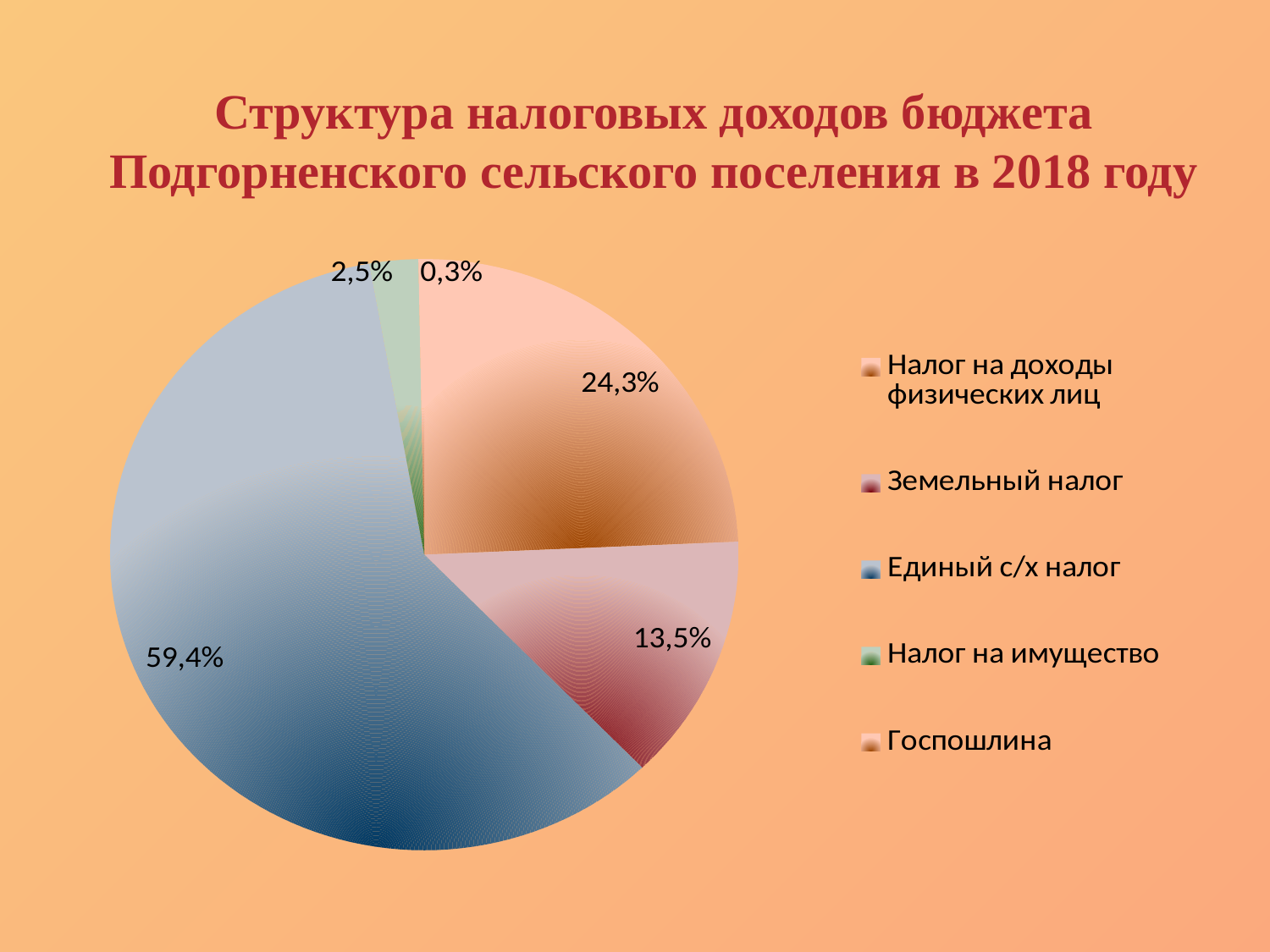
What is the value shown for Земельный налог? 13,5% What type of chart is shown on the slide? Pie chart What is the value shown for Налог на доходы физических лиц? 24,3% What is the title of the chart on the slide? Структура налоговых доходов бюджета Подгорненского сельского поселения в 2018 году What is the value shown for Налог на имущество? 2,5% How many categories does the pie chart have? 5 What share of the pie does Единый с/х налог have? 59,4% What is the difference between the shares of Налог на доходы физических лиц and Земельный налог? 10,8% What is the value shown for Госпошлина? 0,3% Which category has the smallest slice of the pie? Госпошлина Which category has the largest slice of the pie? Единый с/х налог Which is larger, the share of Земельный налог or the share of Налог на имущество? Земельный налог